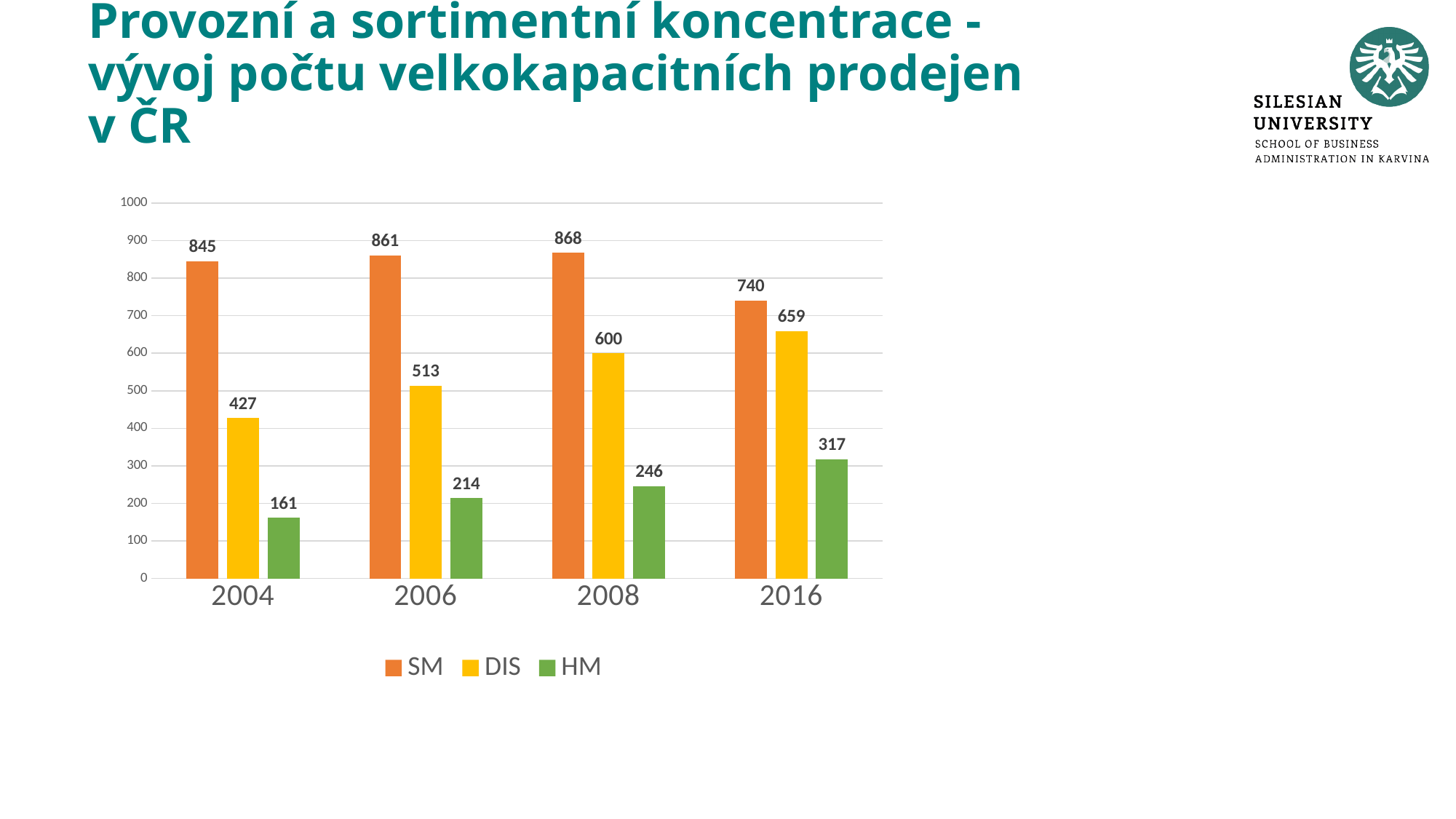
What is the value for DIS in 2016? 659 How many series does the legend list? 3 In which year is the HM value lowest? 2004 What is the value for HM in 2008? 246 Do the DIS values rise or fall from 2004 to 2016? rise Which is larger, the DIS value in 2006 or the DIS value in 2008? DIS in 2008 Is the HM value in 2016 greater or less than 300? greater What is the difference between the SM and DIS values in 2016? 81 In which year is the SM value highest? 2008 How many years are shown on the x axis? 4 What kind of chart is shown on the slide? bar chart What is the value for SM in 2004? 845